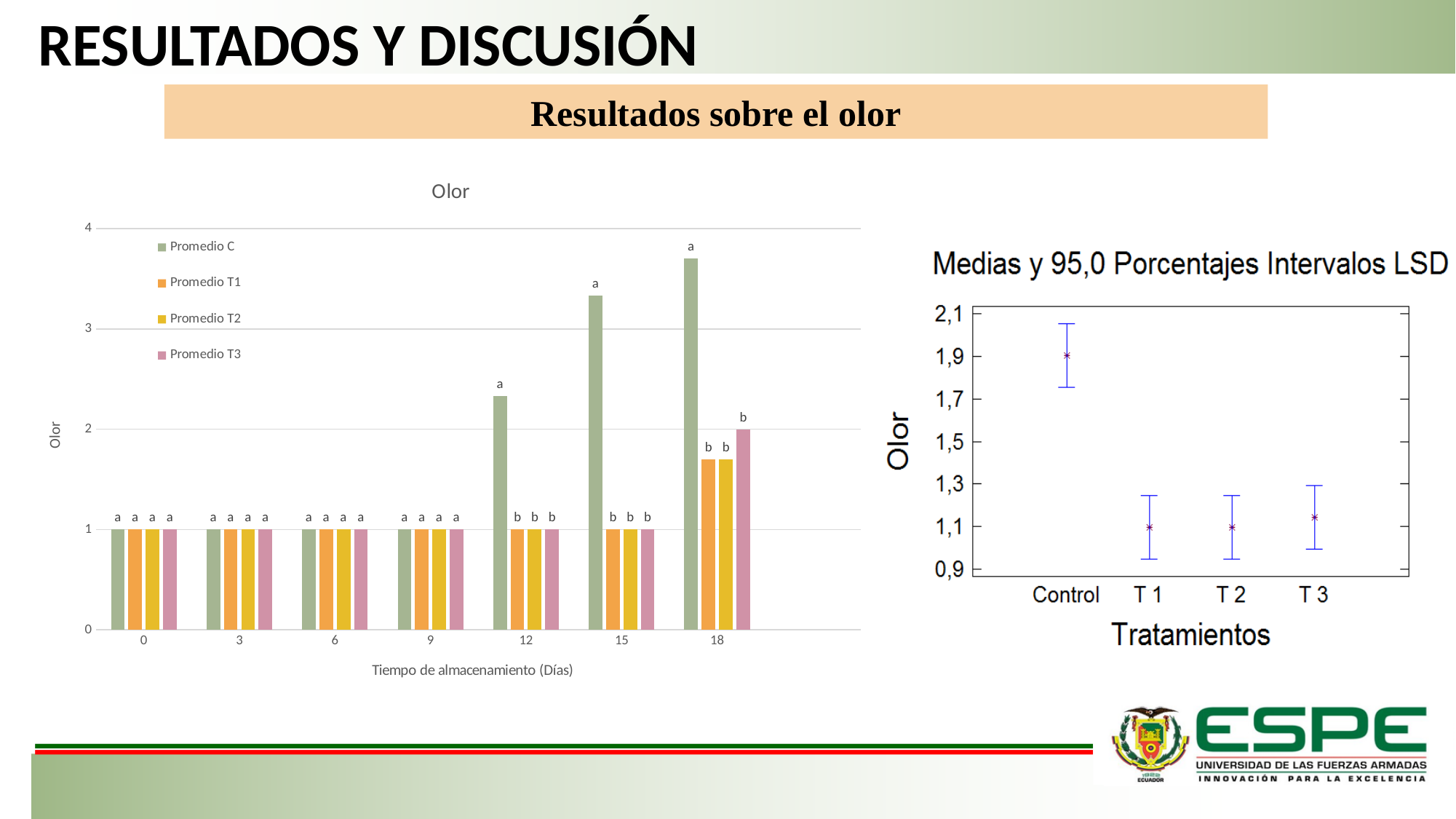
In the 'Olor' chart on the left, does Promedio C rise or fall as storage time increases from day 9 to day 18? rise In the 'Olor' chart on the left, is the value of Promedio T1 at day 18 greater or less than 2? less In the 'Olor' chart on the left, what is the value of Promedio C at day 0? 1 In the 'Olor' chart on the left, what kind of chart is it? bar chart In the 'Olor' chart on the left, how many series does the legend list? 4 In the 'Olor' chart on the left, at day 18, which is larger: Promedio C or Promedio T1? Promedio C In the 'Medias y 95,0 Porcentajes Intervalos LSD' chart on the right, is the mean for Control greater or less than 1,7? greater In the 'Olor' chart on the left, how many storage-time categories are shown on the x axis? 7 In the 'Olor' chart on the left, at which day is Promedio C highest? 18 In the 'Olor' chart on the left, is the value of Promedio C at day 15 greater or less than 3? greater In the 'Medias y 95,0 Porcentajes Intervalos LSD' chart on the right, which treatment has the highest mean Olor? Control In the 'Olor' chart on the left, what is the title of the x axis? Tiempo de almacenamiento (Días)